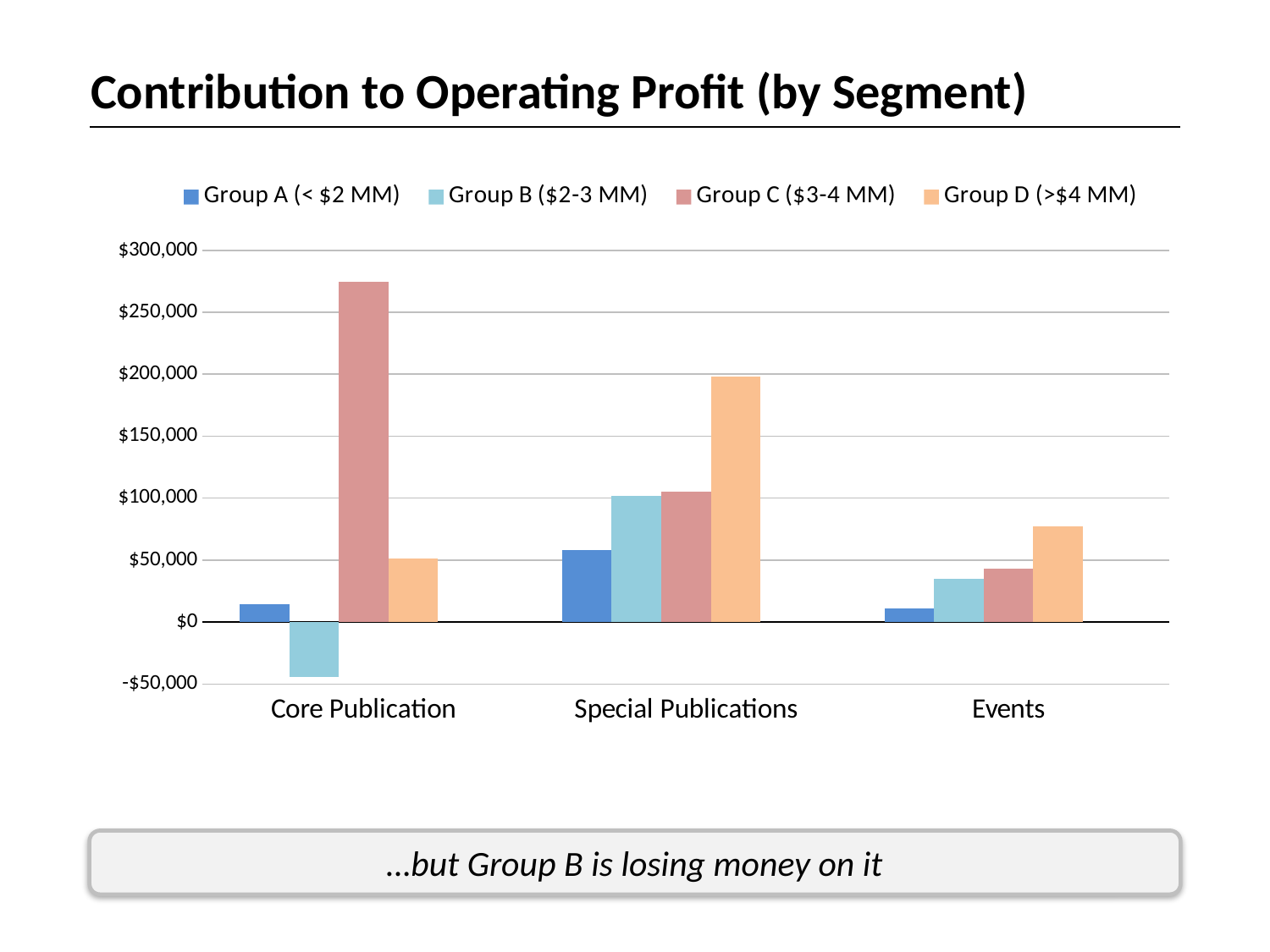
Is the value for Group C ($3-4 MM) in Core Publication greater or less than $250,000? greater Which group has the lowest contribution to operating profit in Events? Group A (< $2 MM) Is the value for Group B ($2-3 MM) in Core Publication greater or less than $0? less Which group has the lowest contribution to operating profit in Core Publication? Group B ($2-3 MM) How many series does the legend list? 4 How many segment categories are shown on the x axis? 3 Which group has the highest contribution to operating profit in Core Publication? Group C ($3-4 MM) Which group has the highest contribution to operating profit in Special Publications? Group D (>$4 MM) What is the title of the chart? Contribution to Operating Profit (by Segment) What kind of chart is shown on the slide? bar chart In Events, which is larger: the value for Group D (>$4 MM) or the value for Group C ($3-4 MM)? Group D (>$4 MM)